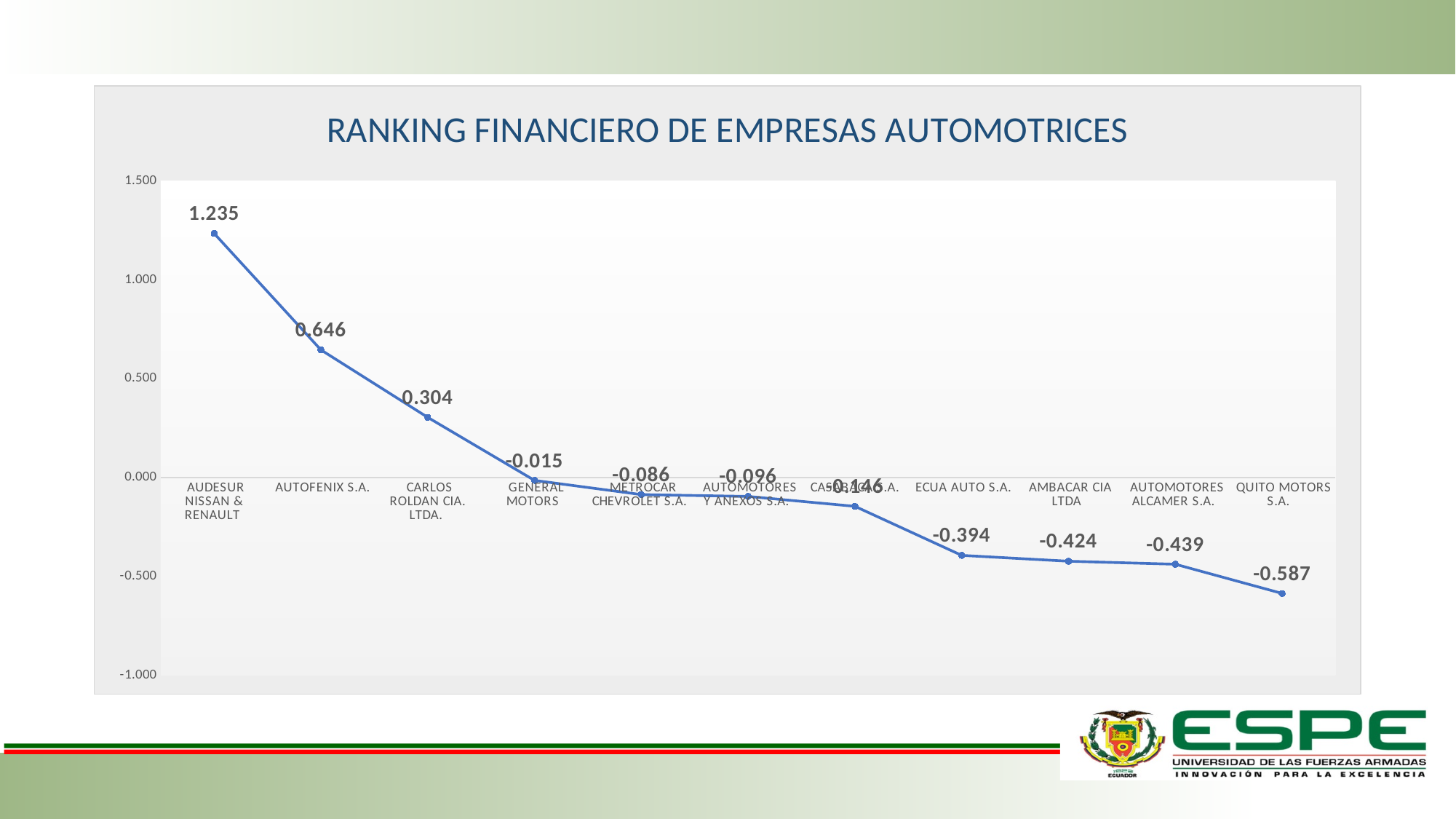
Which has a larger value, CARLOS ROLDAN CIA. LTDA. or ECUA AUTO S.A.? CARLOS ROLDAN CIA. LTDA. What is the value for AUDESUR NISSAN & RENAULT? 1.235 What is the value for AUTOFENIX S.A.? 0.646 Do the values rise or fall from left to right along the x axis? fall What is the value for GENERAL MOTORS? -0.015 How many companies are plotted on the chart? 11 What is the difference between the values for AUDESUR NISSAN & RENAULT and AUTOFENIX S.A.? 0.589 What is the value for QUITO MOTORS S.A.? -0.587 Which company has the lowest value? QUITO MOTORS S.A. Is the value for AMBACAR CIA LTDA greater or less than 0.000? less Which company has the highest value? AUDESUR NISSAN & RENAULT What kind of chart is shown on the slide? line chart